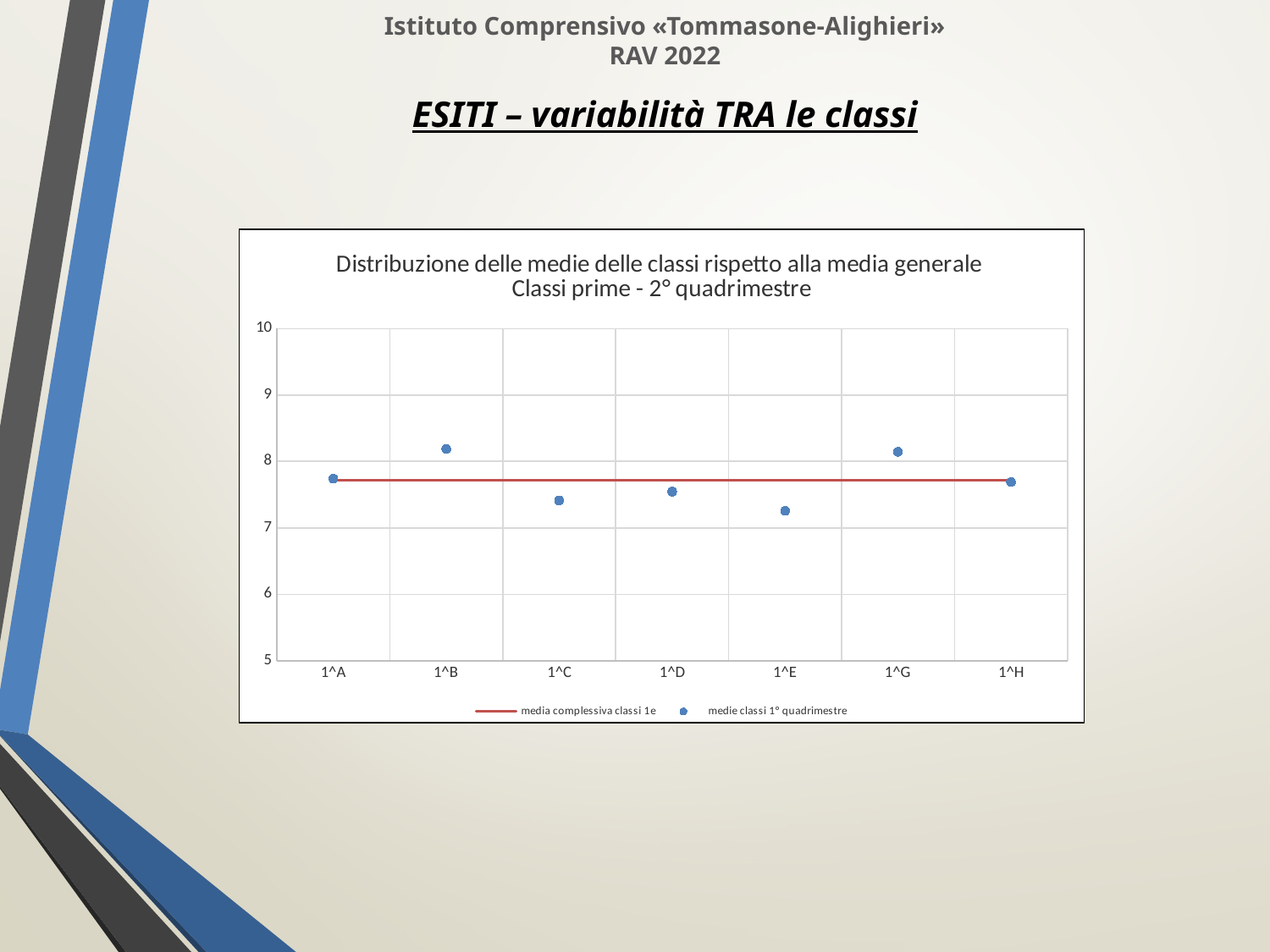
How many series does the chart legend list? 2 What is the title of the chart? Distribuzione delle medie delle classi rispetto alla media generale Classi prime - 2° quadrimestre Which is larger, the value for 1^B or the value for 1^E? 1^B Is the value for 1^C greater or less than 8? less Is the value for 1^B greater or less than 8? greater Which is larger, the value for 1^G or the value for 1^C? 1^G Which class has the lowest average in the chart? 1^E How many classes are shown on the x axis of the chart? 7 Is the value for 1^E greater or less than 7? greater What does the red horizontal line in the chart represent, according to the legend? media complessiva classi 1e